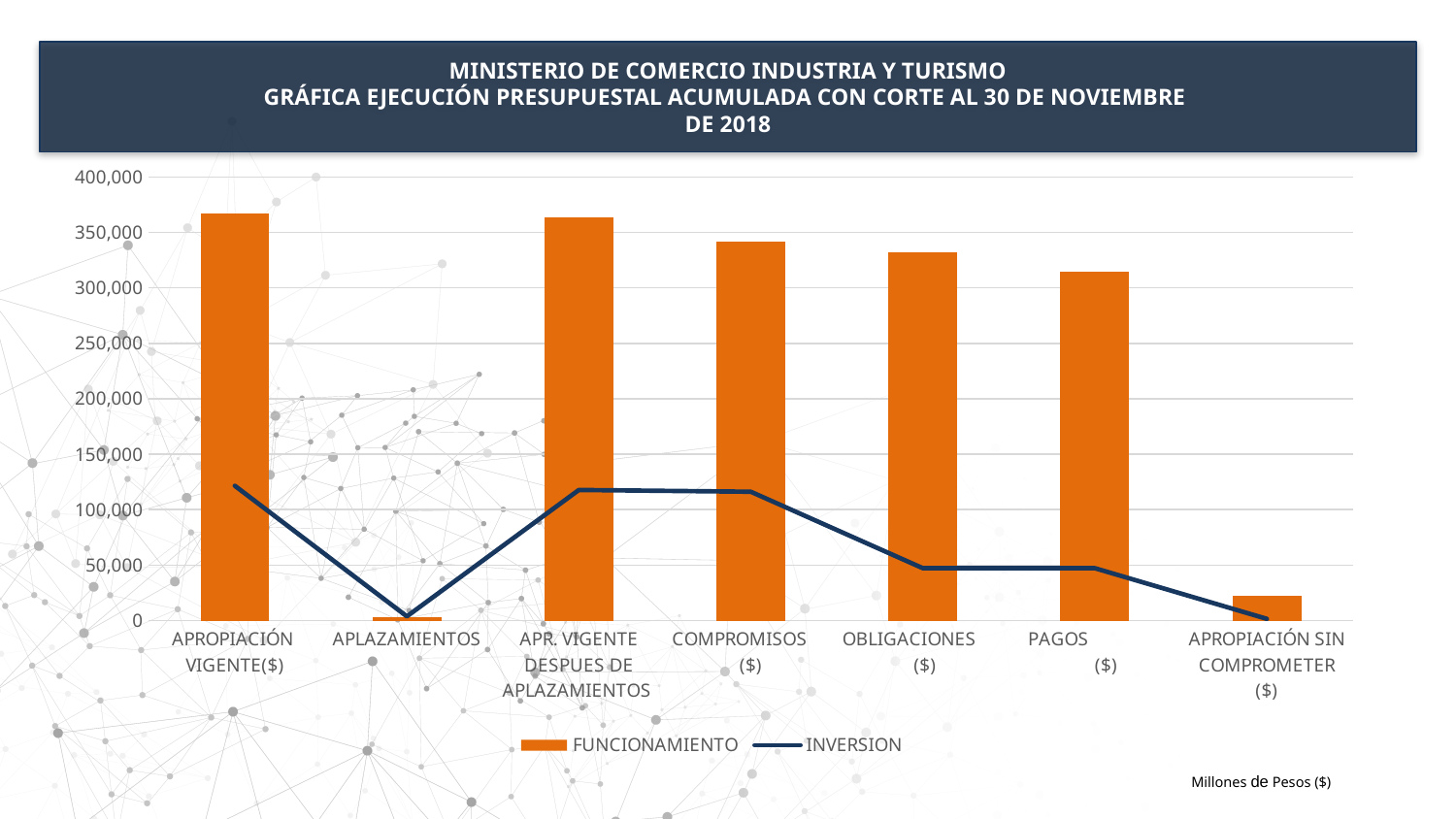
Is the INVERSION value for APROPIACIÓN VIGENTE($) greater or less than 100,000? greater Which category has the lowest FUNCIONAMIENTO bar? APLAZAMIENTOS What unit is stated in the note at the bottom right of the chart? Millones de Pesos ($) Which has the larger INVERSION value, COMPROMISOS ($) or OBLIGACIONES ($)? COMPROMISOS ($) Is the FUNCIONAMIENTO value for COMPROMISOS ($) greater or less than 300,000? greater Is the FUNCIONAMIENTO value for APROPIACIÓN SIN COMPROMETER ($) greater or less than 50,000? less Which series is drawn as a line in the chart? INVERSION How many categories are shown on the x axis of the chart? 7 Which has the larger FUNCIONAMIENTO value, COMPROMISOS ($) or PAGOS ($)? COMPROMISOS ($) How many series does the chart's legend list? 2 Do the FUNCIONAMIENTO bars rise or fall from COMPROMISOS ($) to APROPIACIÓN SIN COMPROMETER ($)? fall